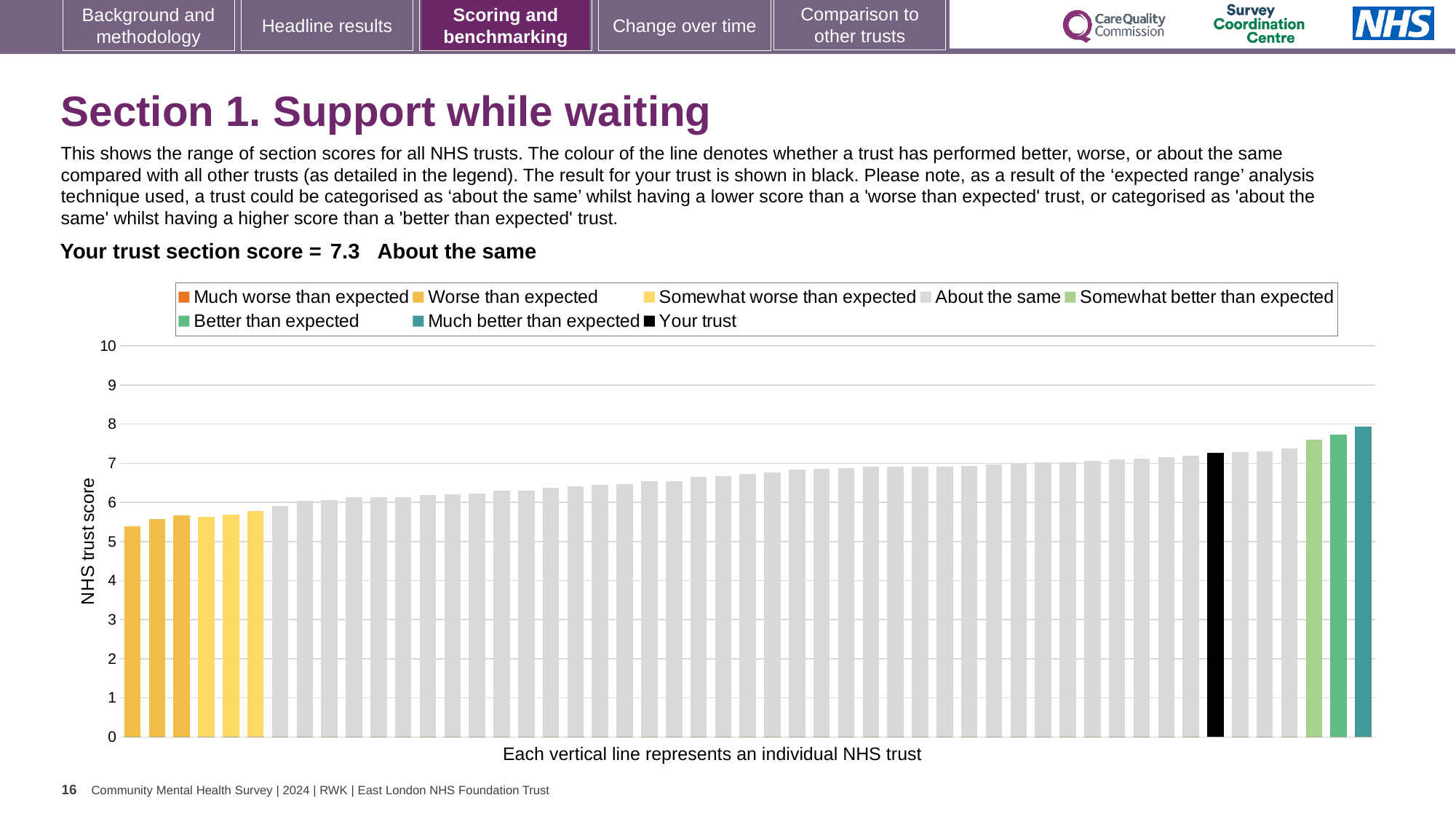
What is the title of the vertical axis? NHS trust score Which legend category does the highest bar in the chart belong to? Much better than expected How many entries does the chart legend list? 8 What kind of chart is shown on the slide? bar chart What colour is the bar representing your trust? black Is the 'Your trust' bar higher or lower than the highest bar in the chart? lower What is the section score for your trust shown on the slide? 7.3 Is the value of the highest bar in the chart greater or less than 8? less Is the value of the lowest bar in the chart greater or less than 6? less Is the value of the black 'Your trust' bar greater or less than 7? greater Do the bar values rise or fall from left to right along the x axis? rise